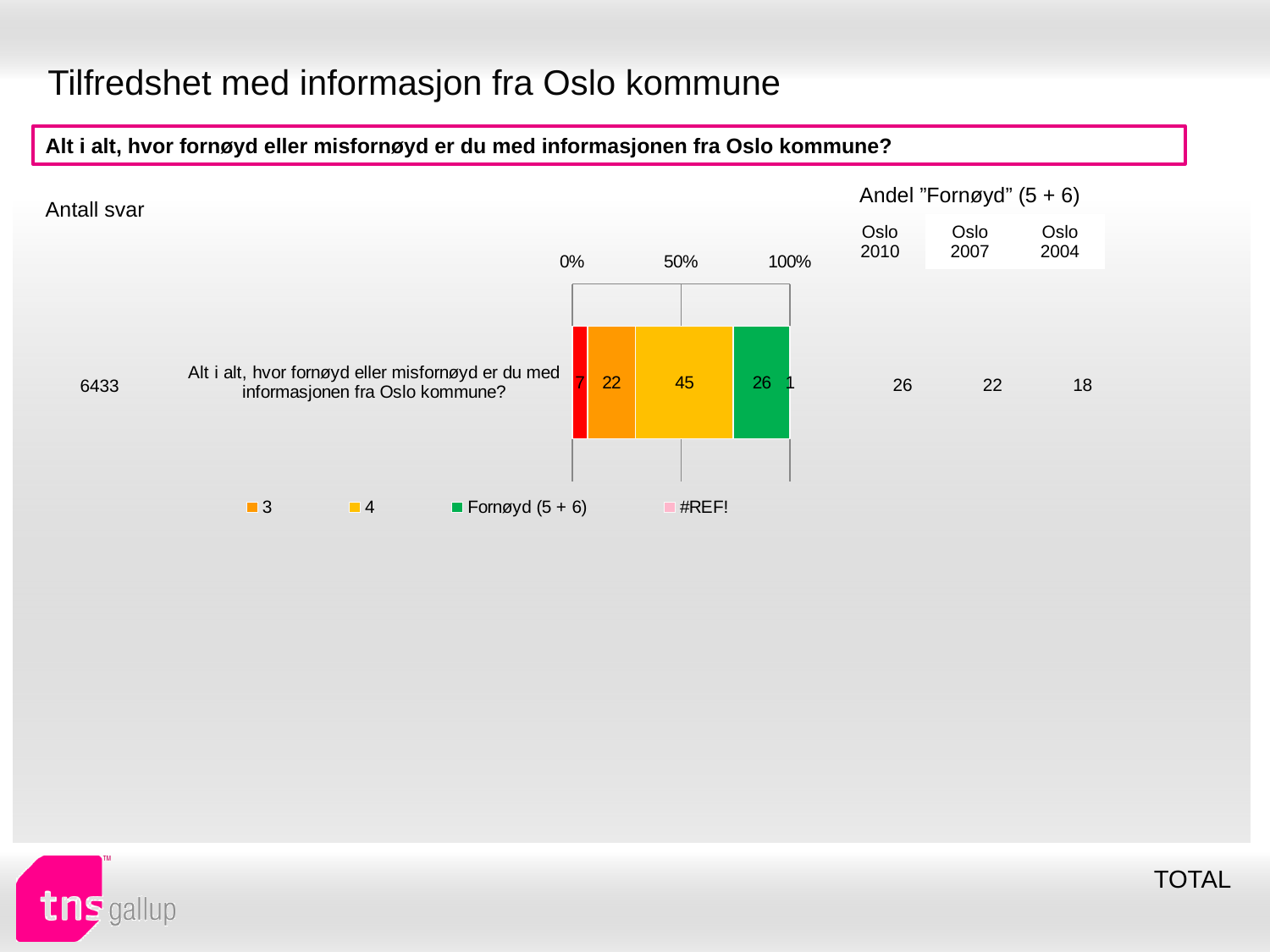
What is the number of responses (Antall svar) shown for the question? 6433 What is the difference between the "4" segment and the "3" segment in the stacked bar? 23 In the "Andel Fornøyd (5 + 6)" table, does the share rise or fall from Oslo 2004 to Oslo 2010? rise In the "Andel Fornøyd (5 + 6)" table, what is the difference between Oslo 2010 and Oslo 2004? 8 Which is larger in the stacked bar: the "Fornøyd (5 + 6)" segment or the "3" segment? Fornøyd (5 + 6) What is the value of the segment labelled "3" in the stacked bar? 22 What is the value of the segment labelled "4" in the stacked bar? 45 What is the last entry listed in the chart legend? #REF! What is the value of the "Fornøyd (5 + 6)" segment in the stacked bar? 26 What kind of chart is shown on the slide? bar chart Which legend category has the largest segment in the stacked bar? 4 In the "Andel Fornøyd (5 + 6)" table, what is the value for Oslo 2007? 22